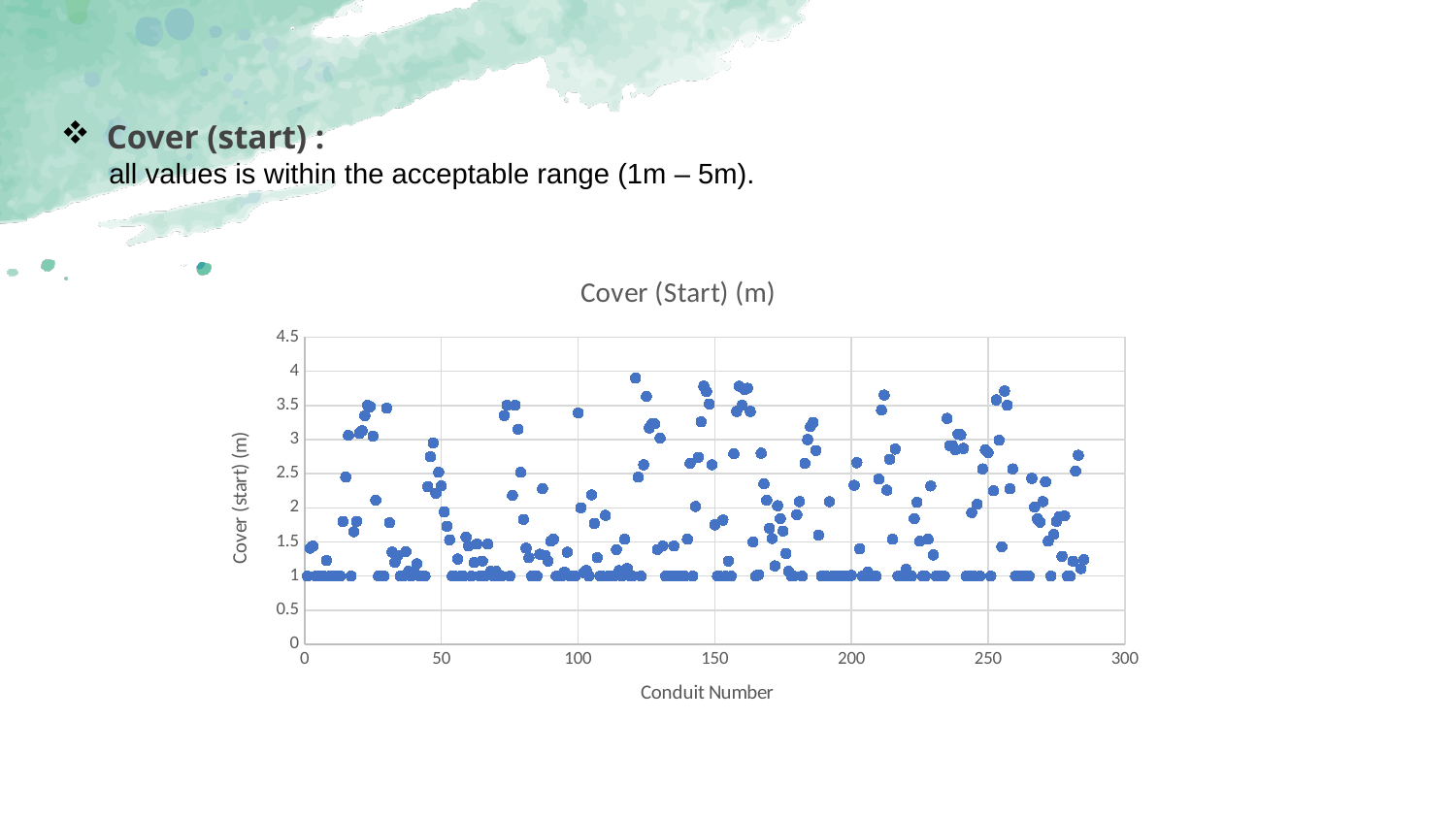
Are any points on the chart plotted above the 4 gridline on the y axis? No What is the label of the x axis of the chart? Conduit Number Are any points on the chart plotted below the 1 gridline on the y axis? No What is the title of the chart? Cover (Start) (m) What kind of chart is shown on the slide? scatter chart Is the highest plotted value on the chart greater or less than 4? less What is the highest tick value shown on the x axis of the chart? 300